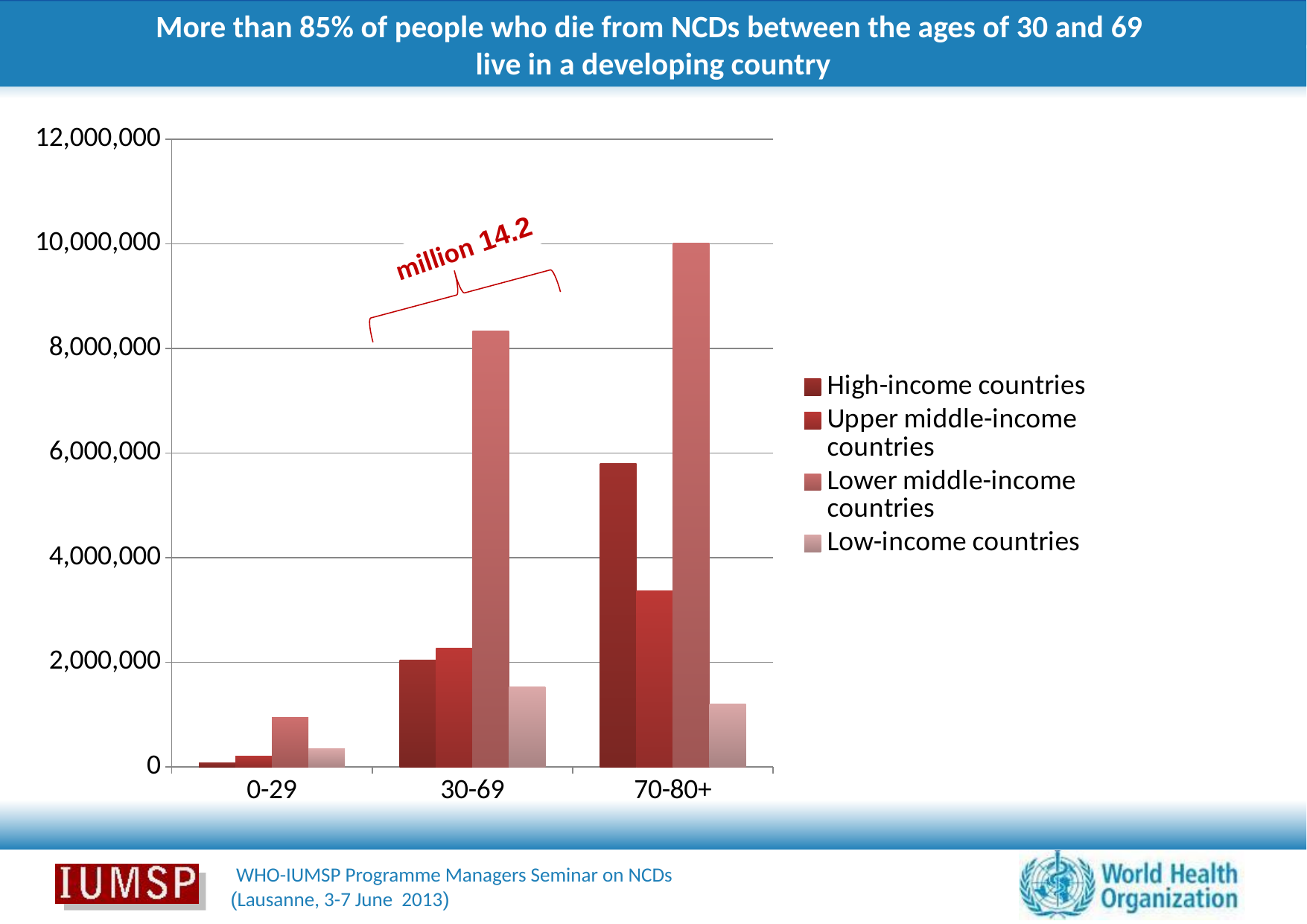
Is the value for Lower middle-income countries in the 30-69 age group greater or less than 8,000,000? greater Do the values for Lower middle-income countries rise or fall from the 0-29 group to the 70-80+ group? rise What total is annotated above the 30-69 age group? 14.2 million How many series does the legend list? 4 Which age group has the lowest value for High-income countries? 0-29 How many age-group categories are shown on the x axis? 3 What kind of chart is shown on the slide? bar chart Is the value for Low-income countries in the 30-69 age group greater or less than 2,000,000? less Which age group has the highest value for Lower middle-income countries? 70-80+ In the 70-80+ age group, which is larger: High-income countries or Upper middle-income countries? High-income countries Is the value for High-income countries in the 70-80+ age group greater or less than 6,000,000? less Which series is shown in the lightest pink colour in the legend? Low-income countries